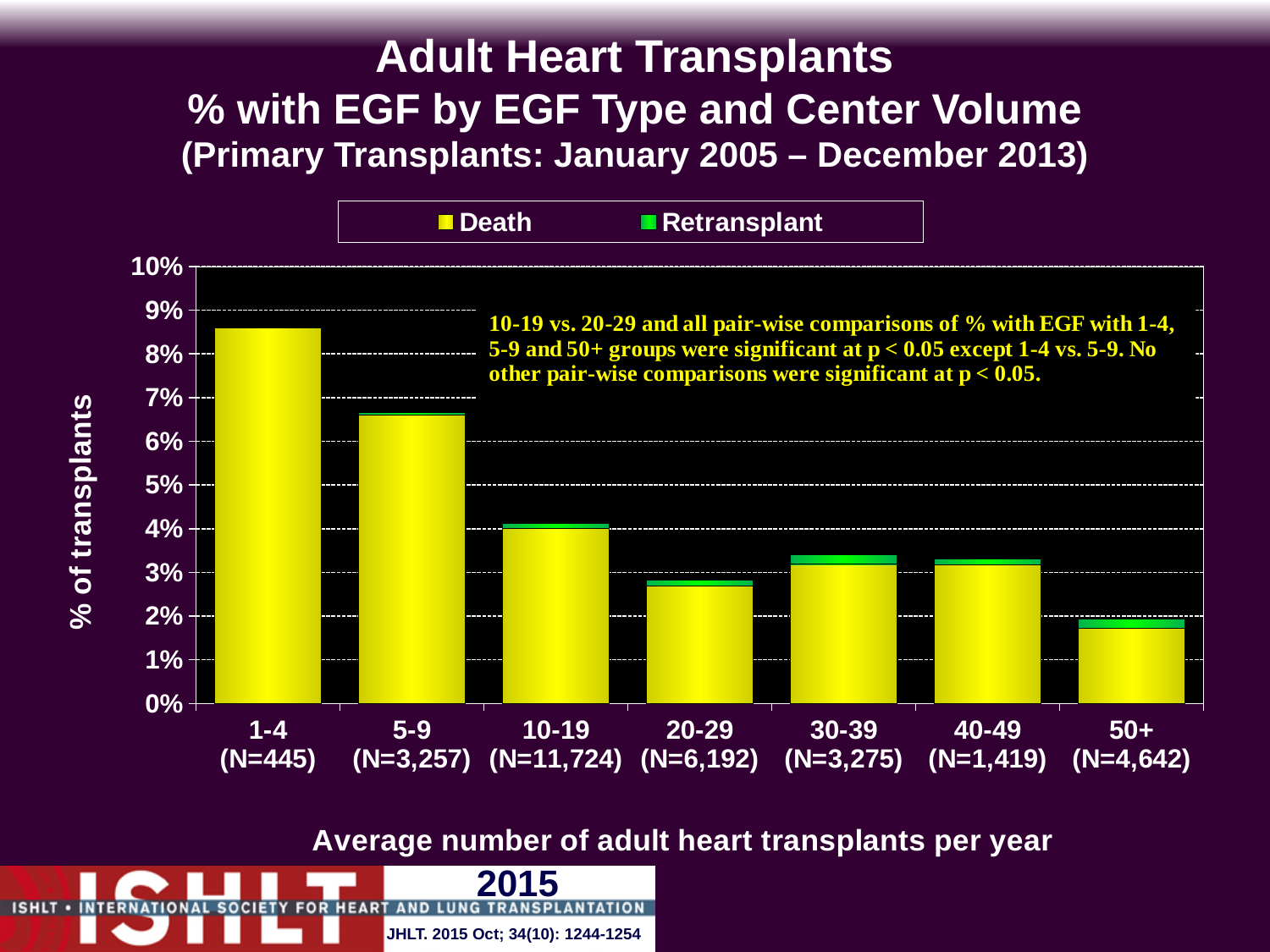
Is the total value for the 5-9 group greater or less than 6%? greater Is the total value for the 1-4 group greater or less than 8%? greater How many center volume categories are shown on the x axis? 7 Which has a larger total % with EGF, the 1-4 group or the 5-9 group? 1-4 Which center volume group has the lowest total % of transplants with EGF? 50+ (N=4,642) What kind of chart is shown on the slide? bar chart Which center volume group has the highest total % of transplants with EGF? 1-4 (N=445) Which has a larger total % with EGF, the 20-29 group or the 30-39 group? 30-39 How many series does the legend list? 2 What are the two series named in the legend? Death and Retransplant Is the total value for the 20-29 group greater or less than 3%? less